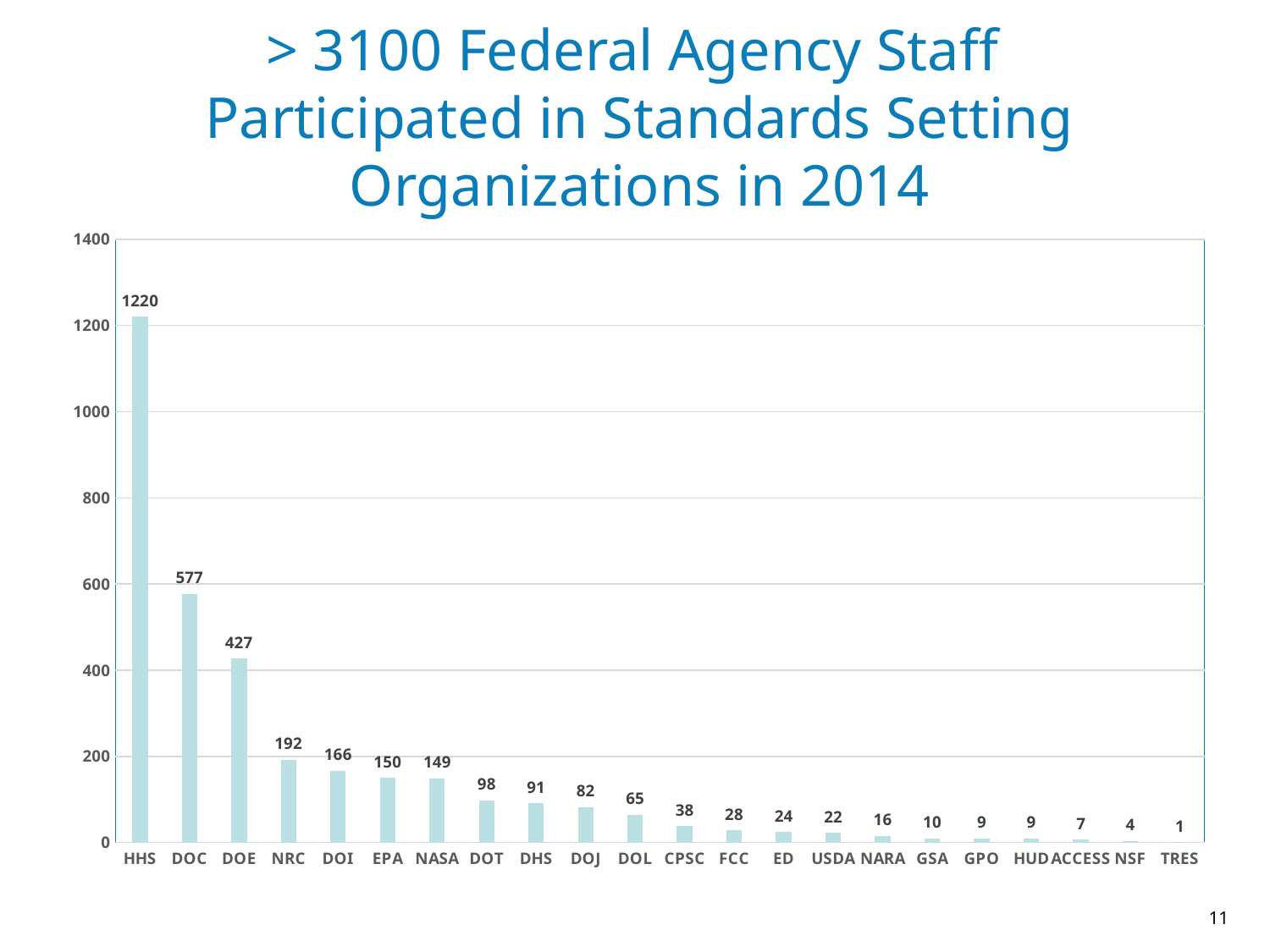
What kind of chart is shown on the slide? bar chart Which is larger, the value for DOT or the value for DHS? DOT What is the value for HHS? 1220 How many agencies are shown on the x axis? 22 Which agency has the lowest value? TRES What is the value for NASA? 149 Which agency has the highest value? HHS What is the difference between the values for DOC and DOE? 150 What is the title of the slide? > 3100 Federal Agency Staff Participated in Standards Setting Organizations in 2014 Is the value for NRC greater or less than 200? less What is the value for USDA? 22 Do the values rise or fall from left to right along the x axis? fall